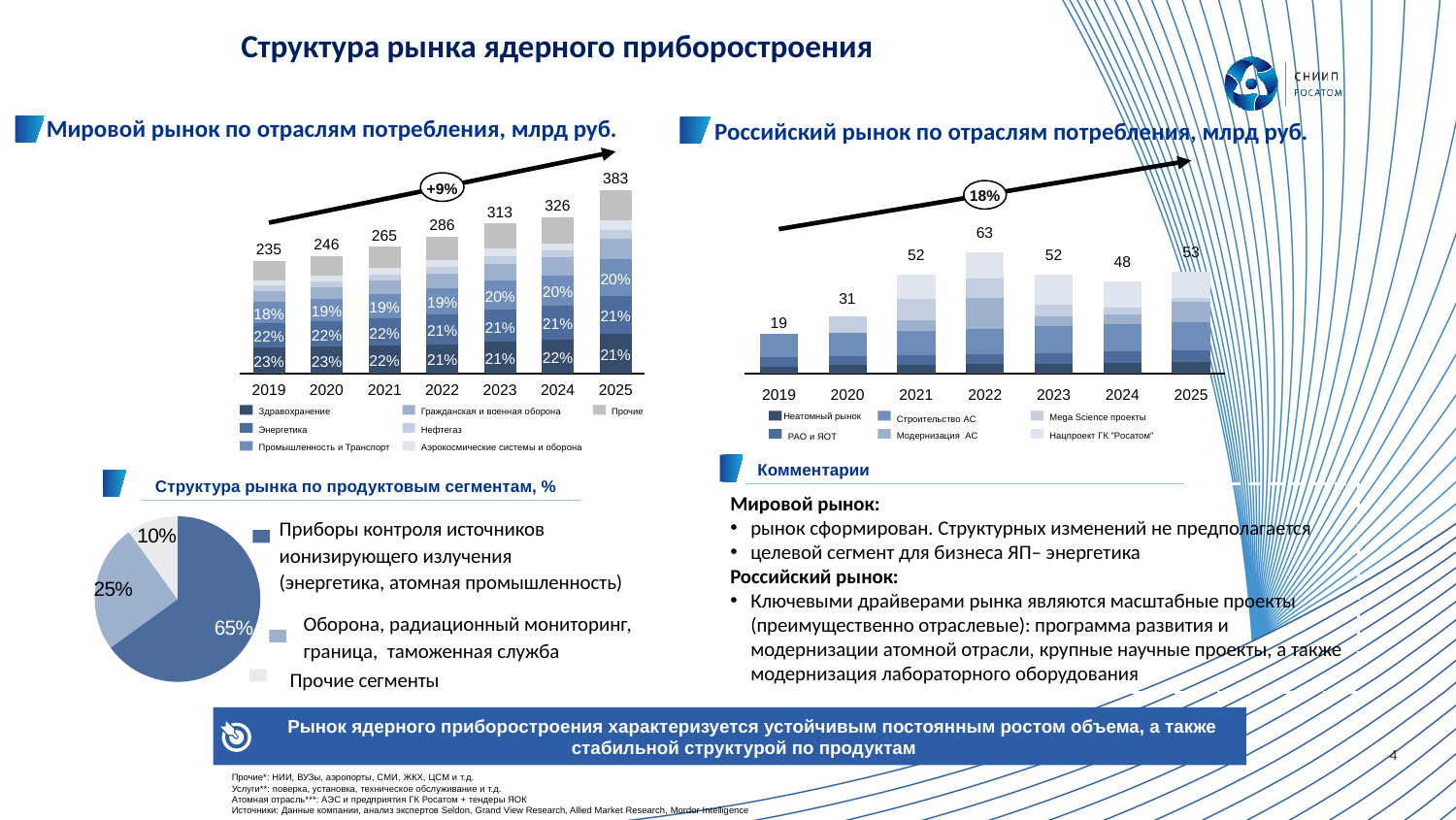
On the 'Мировой рынок по отраслям потребления, млрд руб.' chart, what is the difference between the 2025 total and the 2024 total? 57 On the 'Российский рынок по отраслям потребления, млрд руб.' chart, which year has the lowest total? 2019 On the 'Мировой рынок по отраслям потребления, млрд руб.' chart, do the totals rise or fall from 2019 to 2025? rise On the 'Мировой рынок по отраслям потребления, млрд руб.' chart, what growth rate is shown in the oval on the arrow? +9% On the 'Мировой рынок по отраслям потребления, млрд руб.' chart, what is the total value for 2025? 383 On the 'Мировой рынок по отраслям потребления, млрд руб.' chart, what is the total value for 2019? 235 On the 'Структура рынка по продуктовым сегментам, %' chart, what share does the largest slice have? 65% On the 'Российский рынок по отраслям потребления, млрд руб.' chart, what is the total value for 2024? 48 On the 'Российский рынок по отраслям потребления, млрд руб.' chart, which year has the highest total? 2022 What kind of chart is 'Структура рынка по продуктовым сегментам, %'? pie chart On the 'Российский рынок по отраслям потребления, млрд руб.' chart, how many series does the legend list? 6 On the 'Российский рынок по отраслям потребления, млрд руб.' chart, how many years are shown on the x axis? 7